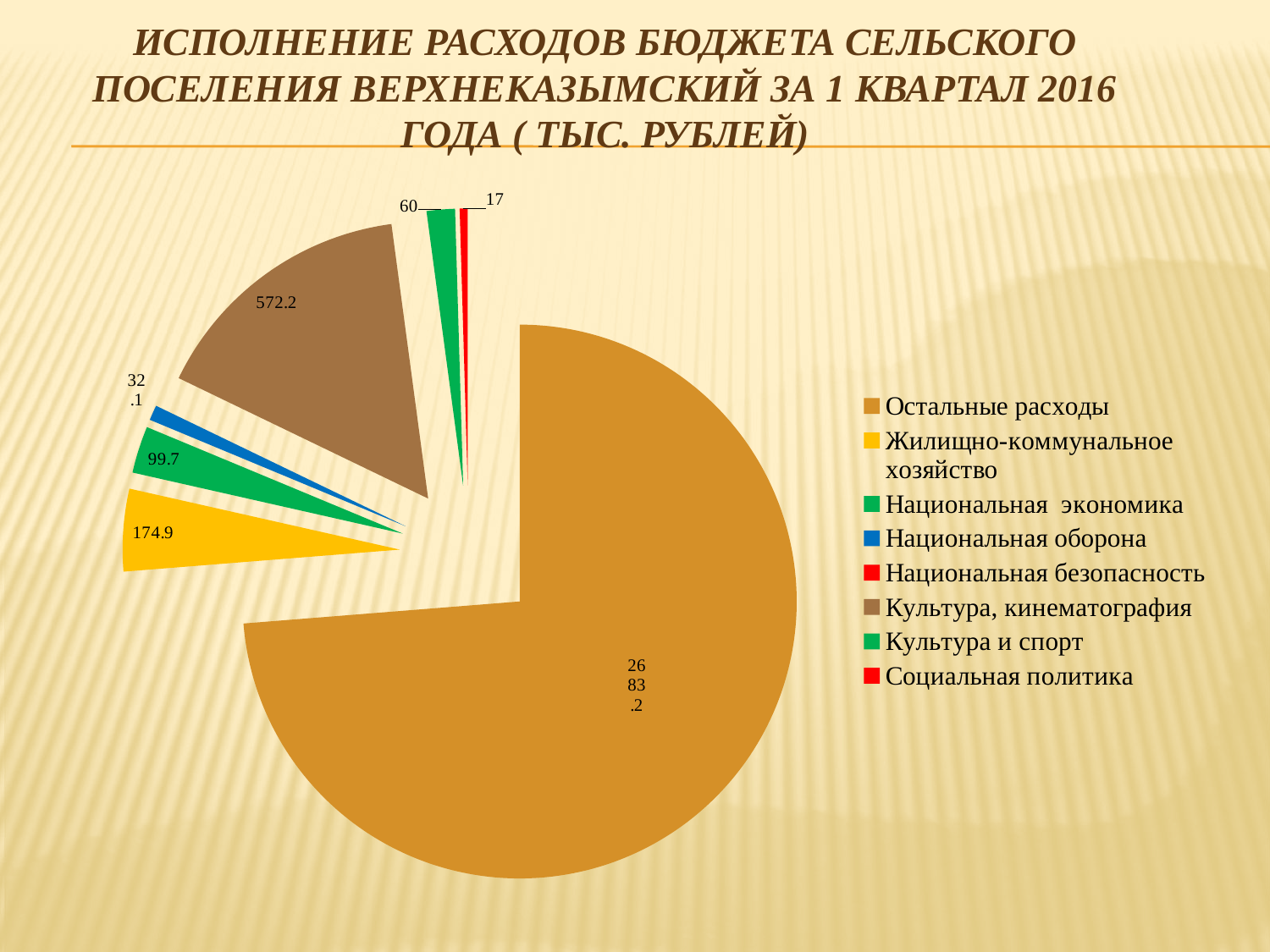
Which is larger, the value for Национальная экономика or the value for Национальная оборона? Национальная экономика What is the value for Культура и спорт? 60 How many categories does the legend of the pie chart list? 8 What is the value for Культура, кинематография? 572.2 Which category has the largest slice of the pie? Остальные расходы What is the value for Социальная политика? 17 What is the value for Остальные расходы? 2683.2 What type of chart is shown on the slide? pie chart What is the value for Национальная экономика? 99.7 What is the value for Жилищно-коммунальное хозяйство? 174.9 What is the difference between the values for Культура, кинематография and Жилищно-коммунальное хозяйство? 397.3 What is the value for Национальная оборона? 32.1